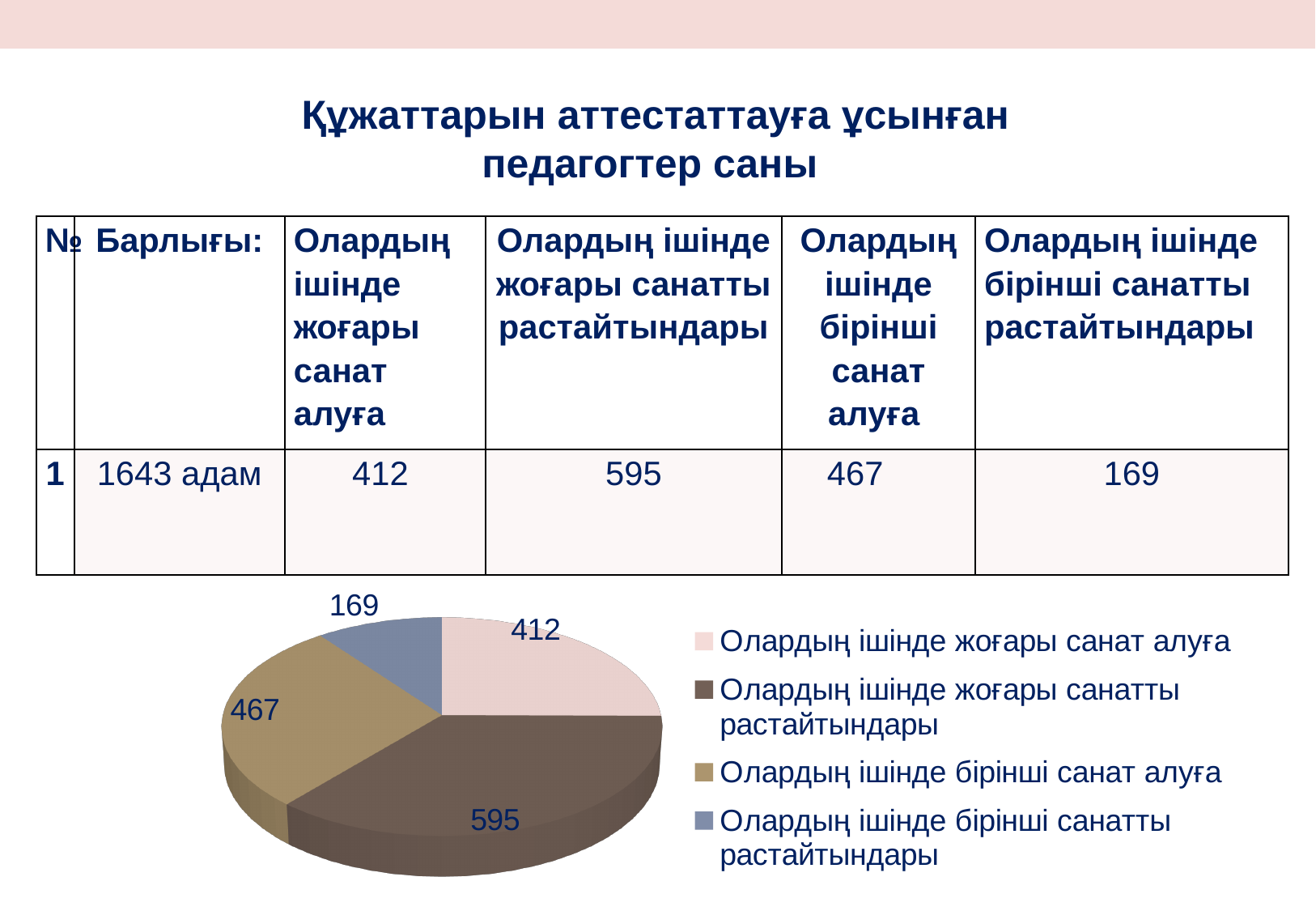
Which is larger in the pie chart: the slice 'Олардың ішінде бірінші санат алуға' or the slice 'Олардың ішінде жоғары санат алуға'? Олардың ішінде бірінші санат алуға What is the difference between the values of the slices 'Олардың ішінде жоғары санатты растайтындары' and 'Олардың ішінде бірінші санат алуға' in the pie chart? 128 What is the value of the slice labelled 'Олардың ішінде жоғары санатты растайтындары' in the pie chart? 595 What kind of chart is shown on the slide? pie chart How many entries does the legend of the pie chart list? 4 What is the value of the slice labelled 'Олардың ішінде жоғары санат алуға' in the pie chart? 412 What colour is the slice labelled 595 in the pie chart? dark brown Which slice of the pie chart has the largest value? Олардың ішінде жоғары санатты растайтындары What is the value of the slice labelled 'Олардың ішінде бірінші санат алуға' in the pie chart? 467 What is the value of the slice labelled 'Олардың ішінде бірінші санатты растайтындары' in the pie chart? 169 Which slice of the pie chart has the smallest value? Олардың ішінде бірінші санатты растайтындары How many slices does the pie chart have? 4